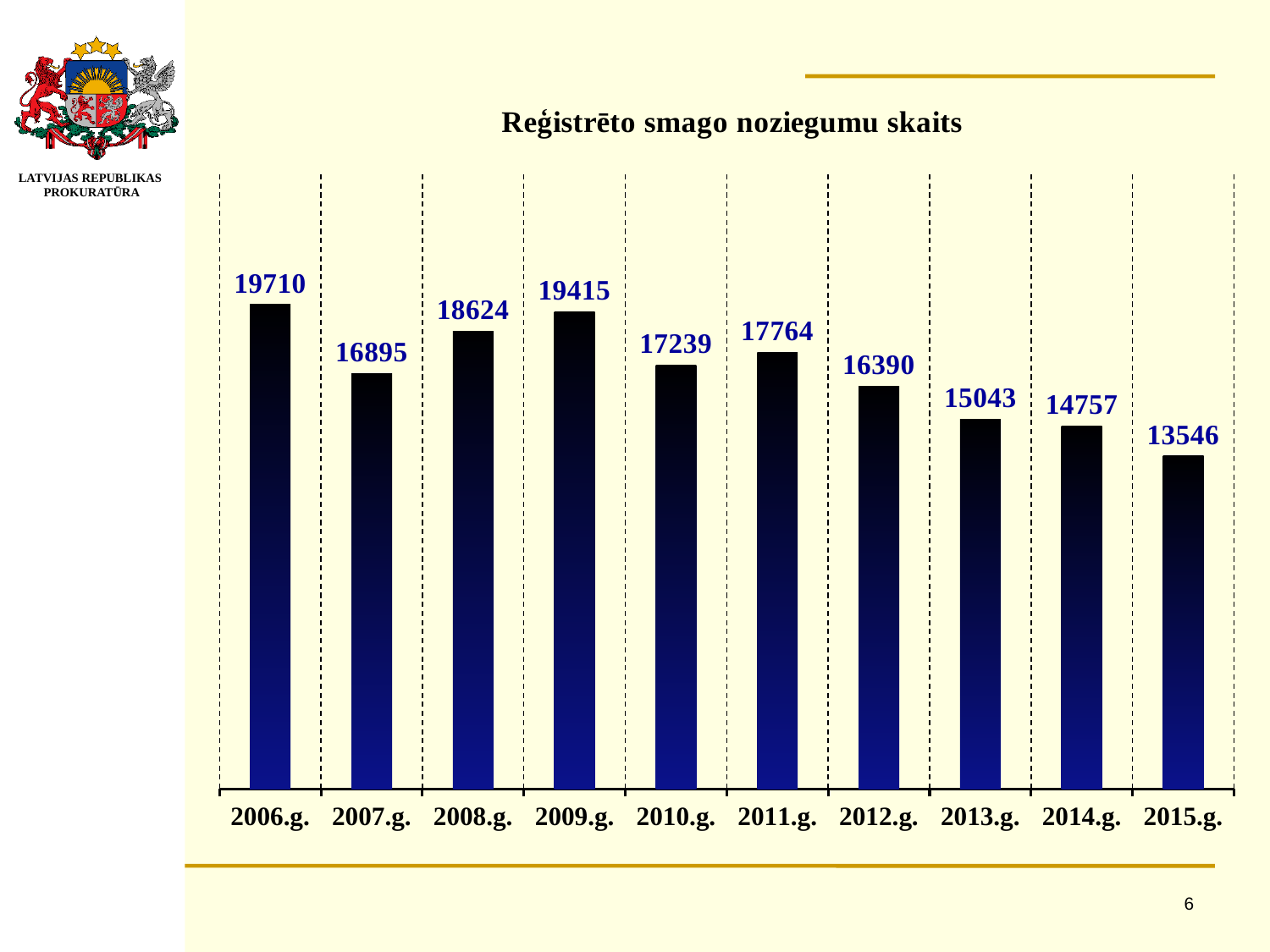
What is the value for 2012.g.? 16390 What is the difference between the values for 2006.g. and 2015.g.? 6164 Which year has the highest value? 2006.g. What is the value for 2015.g.? 13546 What is the value for 2006.g.? 19710 How many years are shown on the chart? 10 Which is larger, the value for 2013.g. or the value for 2014.g.? 2013.g. Which is larger, the value for 2008.g. or the value for 2011.g.? 2008.g. What kind of chart is shown on the slide? Bar chart What is the difference between the values for 2009.g. and 2010.g.? 2176 What is the title of the chart? Reģistrēto smago noziegumu skaits Which year has the lowest value? 2015.g.